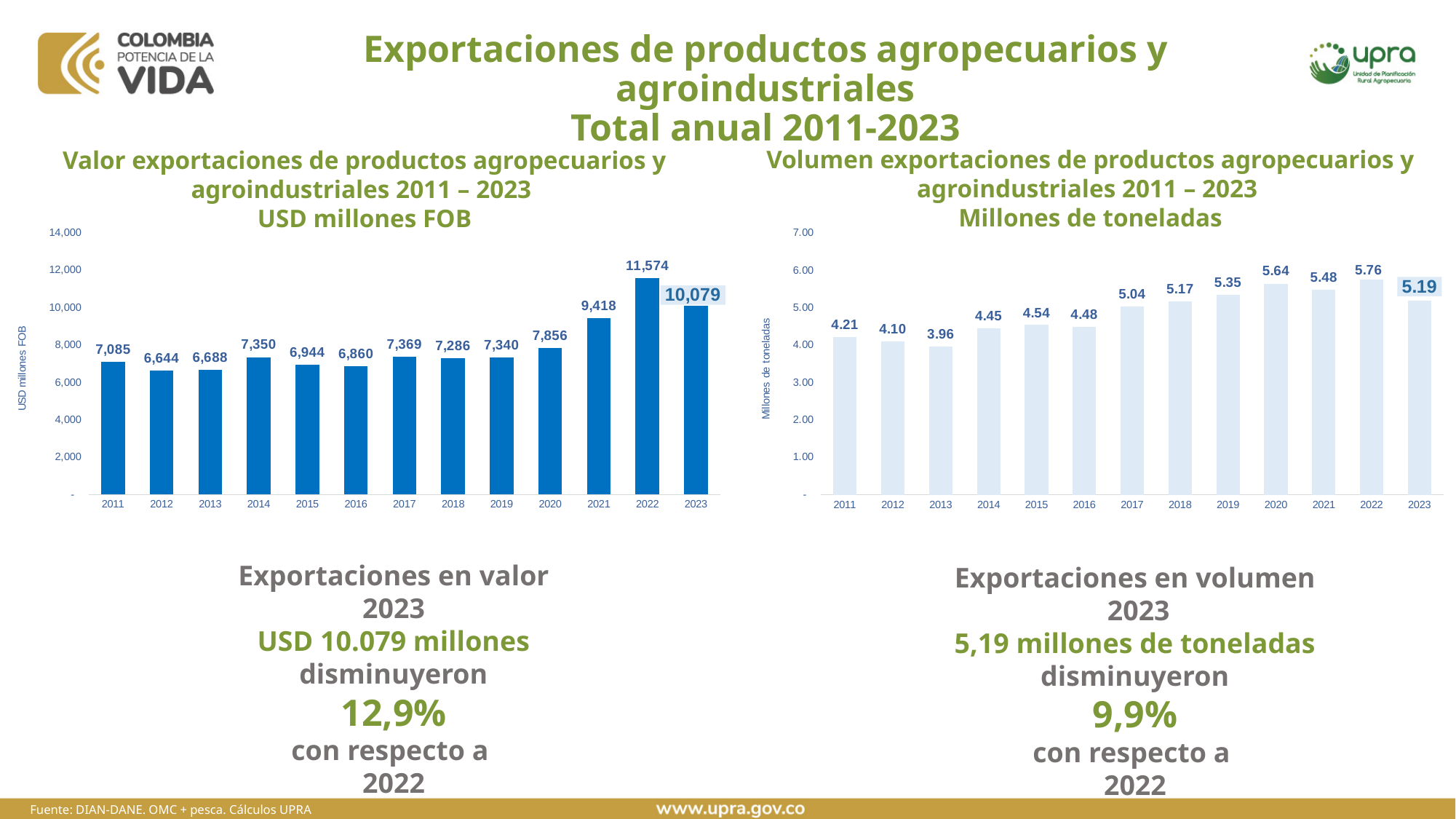
In the right chart (Volumen exportaciones, Millones de toneladas), what is the value for 2023? 5.19 In the right chart (Volumen exportaciones, Millones de toneladas), which is larger, the value for 2020 or the value for 2021? 2020 In the left chart (Valor exportaciones, USD millones FOB), which year has the highest value? 2022 What kind of chart is the right chart (Volumen exportaciones, Millones de toneladas)? Bar chart In the left chart (Valor exportaciones, USD millones FOB), what is the difference between the 2022 and 2023 values? 1,495 In the right chart (Volumen exportaciones, Millones de toneladas), what is the difference between the 2022 and 2023 values? 0.57 In the right chart (Volumen exportaciones, Millones de toneladas), which year has the highest value? 2022 In the right chart (Volumen exportaciones, Millones de toneladas), which year has the lowest value? 2013 In the left chart (Valor exportaciones, USD millones FOB), what is the value for 2012? 6,644 In the left chart (Valor exportaciones, USD millones FOB), how many years are plotted? 13 In the left chart (Valor exportaciones, USD millones FOB), what is the value for 2022? 11,574 In the left chart (Valor exportaciones, USD millones FOB), which year has the lowest value? 2012